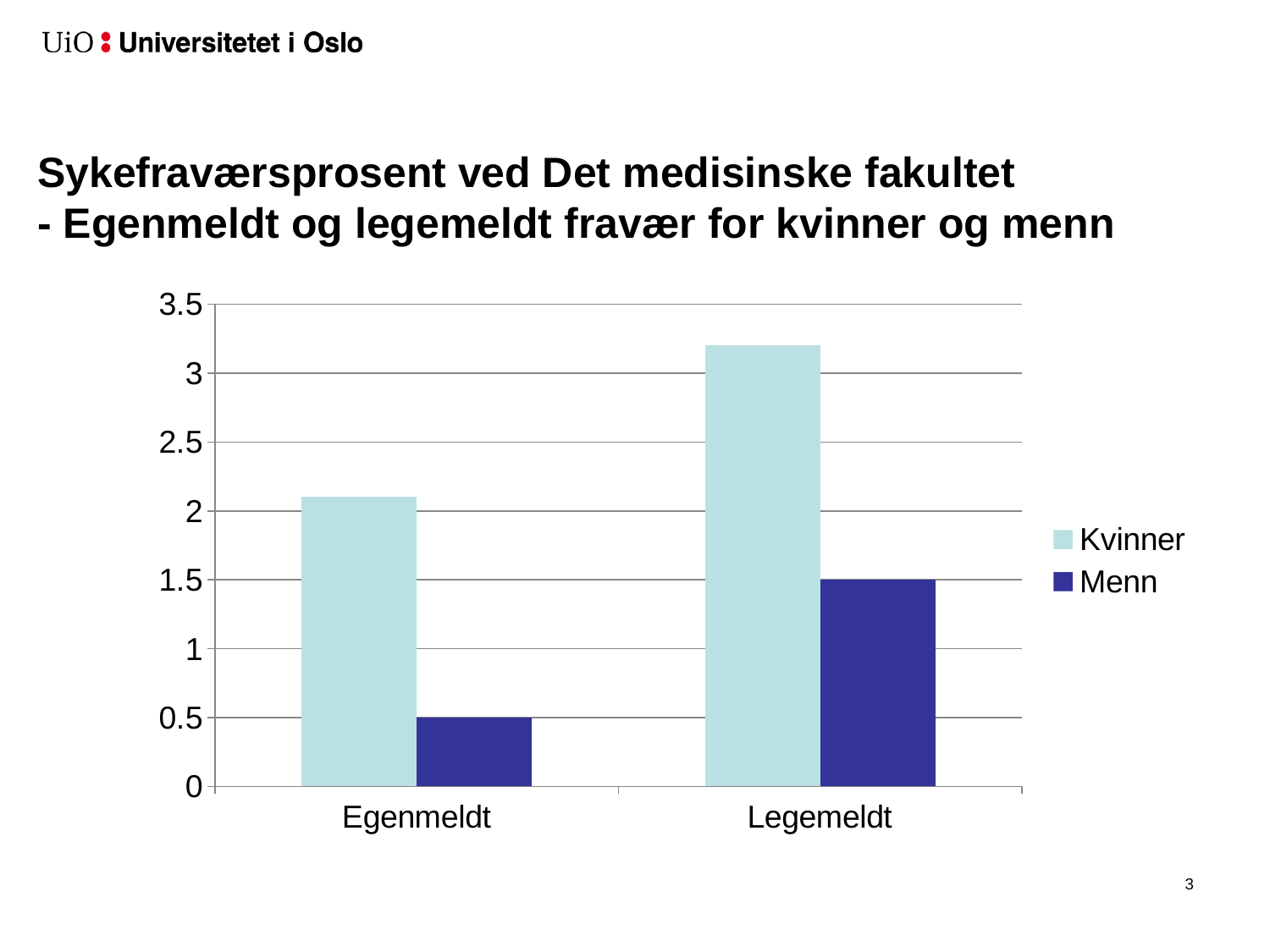
Which category has the lowest value for Menn? Egenmeldt What is the value for Menn in the Legemeldt category? 1.5 What is the value for Menn in the Egenmeldt category? 0.5 Which category has the highest value for Kvinner? Legemeldt Is the value for Kvinner in the Legemeldt category greater or less than 3.5? less Is the value for Kvinner in the Legemeldt category greater or less than 3? greater Is the value for Kvinner in the Egenmeldt category greater or less than 2? greater What is the difference between the Menn values for Legemeldt and Egenmeldt? 1 Which is larger in the Legemeldt category, Kvinner or Menn? Kvinner How many categories are shown on the x axis? 2 What kind of chart is shown on the slide? bar chart How many series does the legend list? 2